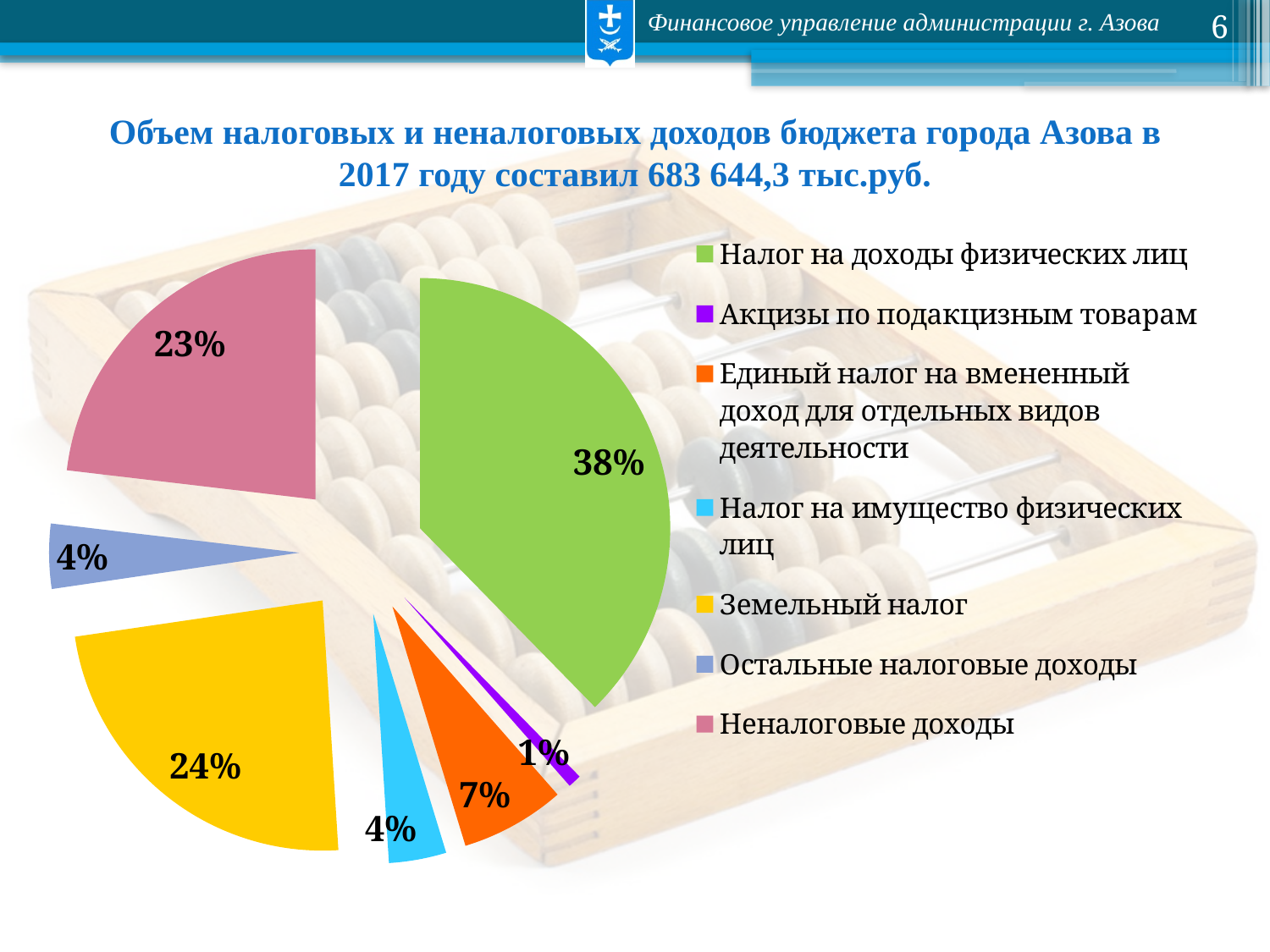
What is the difference in percentage points between the shares of "Налог на доходы физических лиц" and "Земельный налог"? 14 What share of the pie does "Единый налог на вмененный доход для отдельных видов деятельности" have? 7% How many categories does the legend list? 7 What colour is the slice for "Неналоговые доходы"? pink Which is larger: the share of "Земельный налог" or the share of "Неналоговые доходы"? Земельный налог What share of the pie does "Налог на доходы физических лиц" have? 38% Which category has the smallest share of the pie? Акцизы по подакцизным товарам What share of the pie does "Неналоговые доходы" have? 23% What share of the pie does "Акцизы по подакцизным товарам" have? 1% Which category has the largest share of the pie? Налог на доходы физических лиц What share of the pie does "Земельный налог" have? 24% What kind of chart is shown on the slide? pie chart